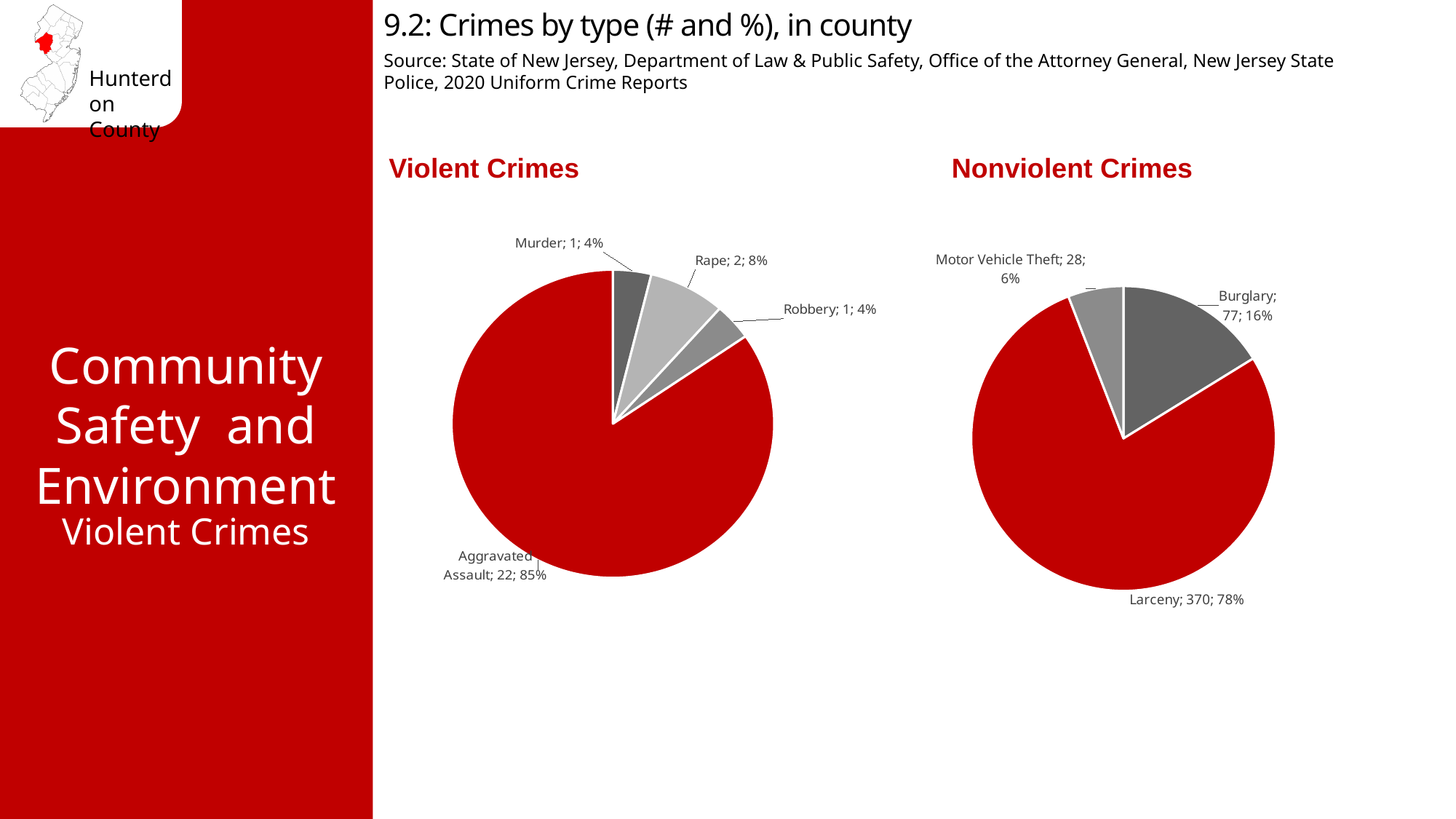
In the Violent Crimes pie chart, how many aggravated assaults are shown? 22 In the Nonviolent Crimes pie chart, how many larceny crimes are shown? 370 In the Nonviolent Crimes pie chart, what percentage share does Burglary have? 16% In the Nonviolent Crimes pie chart, which category has the smallest slice? Motor Vehicle Theft In the Nonviolent Crimes pie chart, what is the difference between the number of burglaries and the number of motor vehicle thefts? 49 In the Violent Crimes pie chart, what percentage share does Rape have? 8% What is the title of the chart on the right side of the slide? Nonviolent Crimes What type of chart is used for the Nonviolent Crimes data? Pie chart In the Violent Crimes pie chart, which category has the largest slice? Aggravated Assault In the Violent Crimes pie chart, how many categories are shown? 4 In the Nonviolent Crimes pie chart, which is larger, Burglary or Motor Vehicle Theft? Burglary In the Violent Crimes pie chart, what is the difference between the number of aggravated assaults and the number of rapes? 20